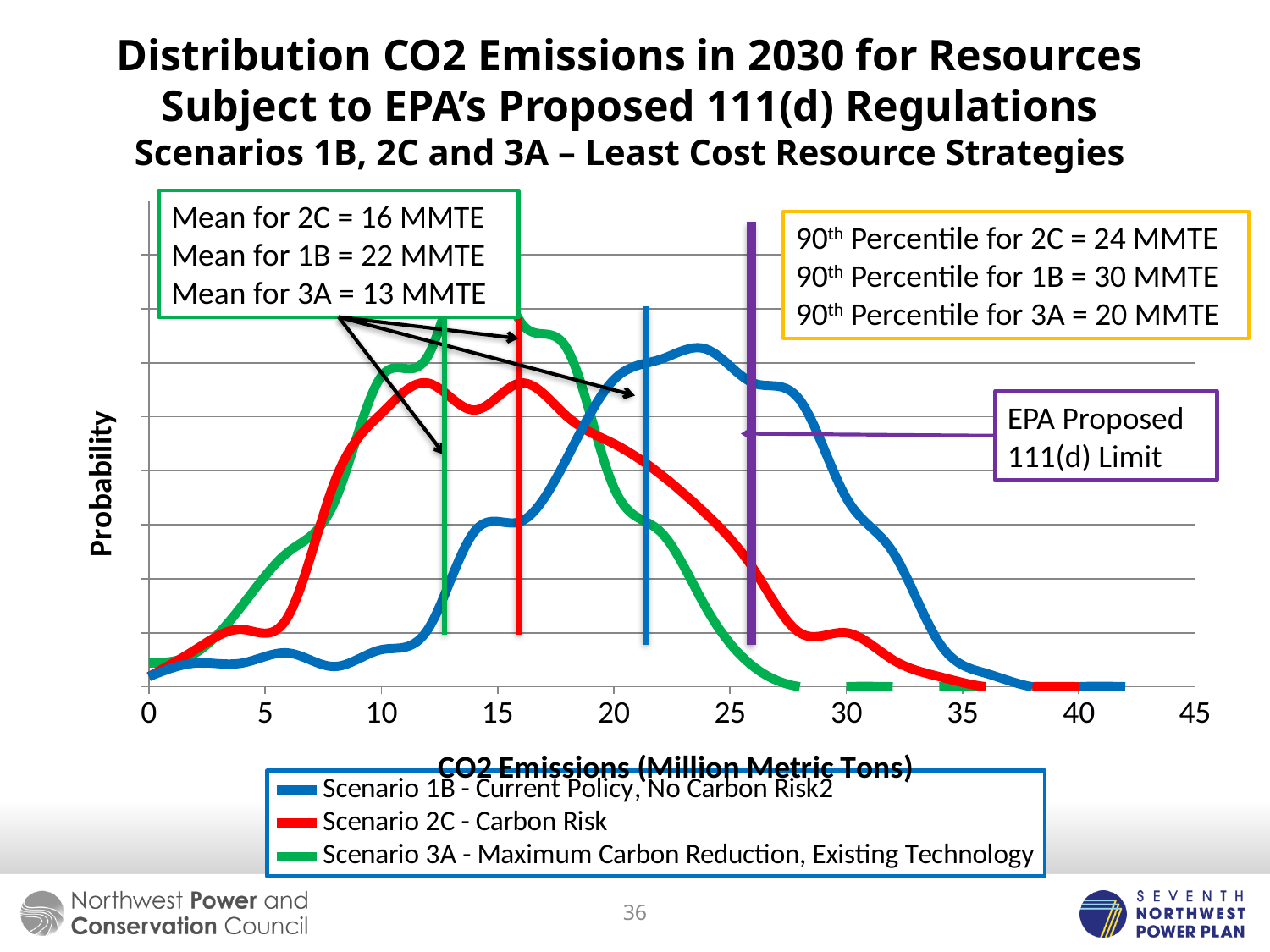
Which scenario has the highest mean CO2 emissions? Scenario 1B What is the 90th percentile CO2 emissions value for Scenario 1B? 30 MMTE What is the 90th percentile CO2 emissions value for Scenario 3A? 20 MMTE What is the title of the x axis? CO2 Emissions (Million Metric Tons) What kind of chart is shown on the slide? Line chart What is the mean CO2 emissions value for Scenario 1B shown on the chart? 22 MMTE Which is larger, the 90th percentile for Scenario 2C or the 90th percentile for Scenario 3A? 90th percentile for Scenario 2C What is the difference between the mean for Scenario 1B and the mean for Scenario 3A? 9 MMTE How many scenarios does the legend list? 3 Which scenario has the lowest 90th percentile CO2 emissions? Scenario 3A Is the EPA Proposed 111(d) Limit on the x axis greater or less than 30? less What is the mean CO2 emissions value for Scenario 2C shown on the chart? 16 MMTE